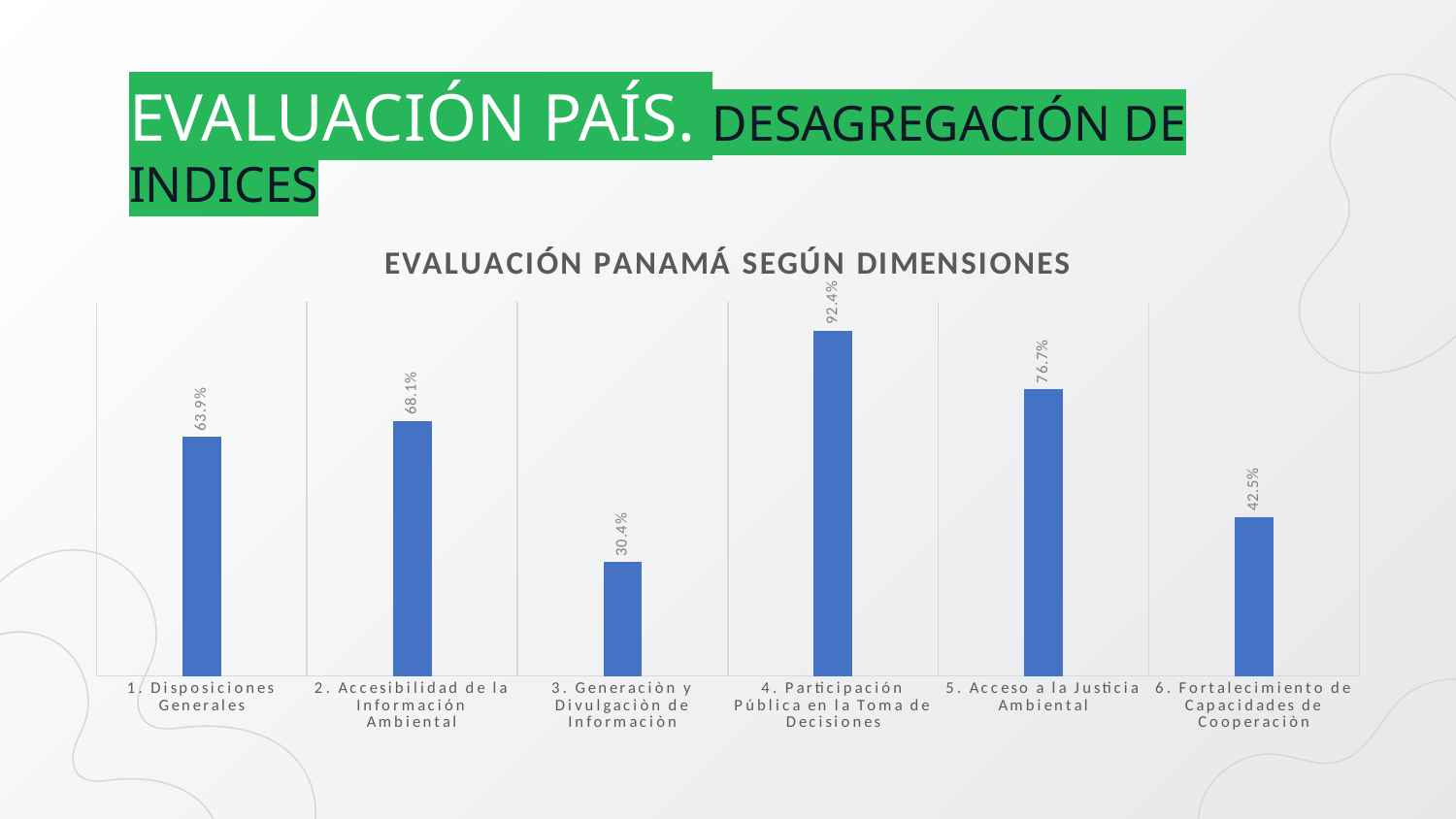
What is the difference between the values for '4. Participación Pública en la Toma de Decisiones' and '6. Fortalecimiento de Capacidades de Cooperaciòn'? 49.9% What colour are the bars in the chart? Blue How many dimensions are shown in the chart? 6 What is the value for '5. Acceso a la Justicia Ambiental'? 76.7% What is the value for '3. Generaciòn y Divulgaciòn de Informaciòn'? 30.4% What kind of chart is shown on the slide? Bar chart What is the difference between the values for '2. Accesibilidad de la Información Ambiental' and '1. Disposiciones Generales'? 4.2% Which dimension has the lowest value? 3. Generaciòn y Divulgaciòn de Informaciòn Which is larger, the value for '5. Acceso a la Justicia Ambiental' or the value for '2. Accesibilidad de la Información Ambiental'? 5. Acceso a la Justicia Ambiental What is the value for '1. Disposiciones Generales'? 63.9% What is the title of the chart? EVALUACIÓN PANAMÁ SEGÚN DIMENSIONES Which dimension has the highest value? 4. Participación Pública en la Toma de Decisiones